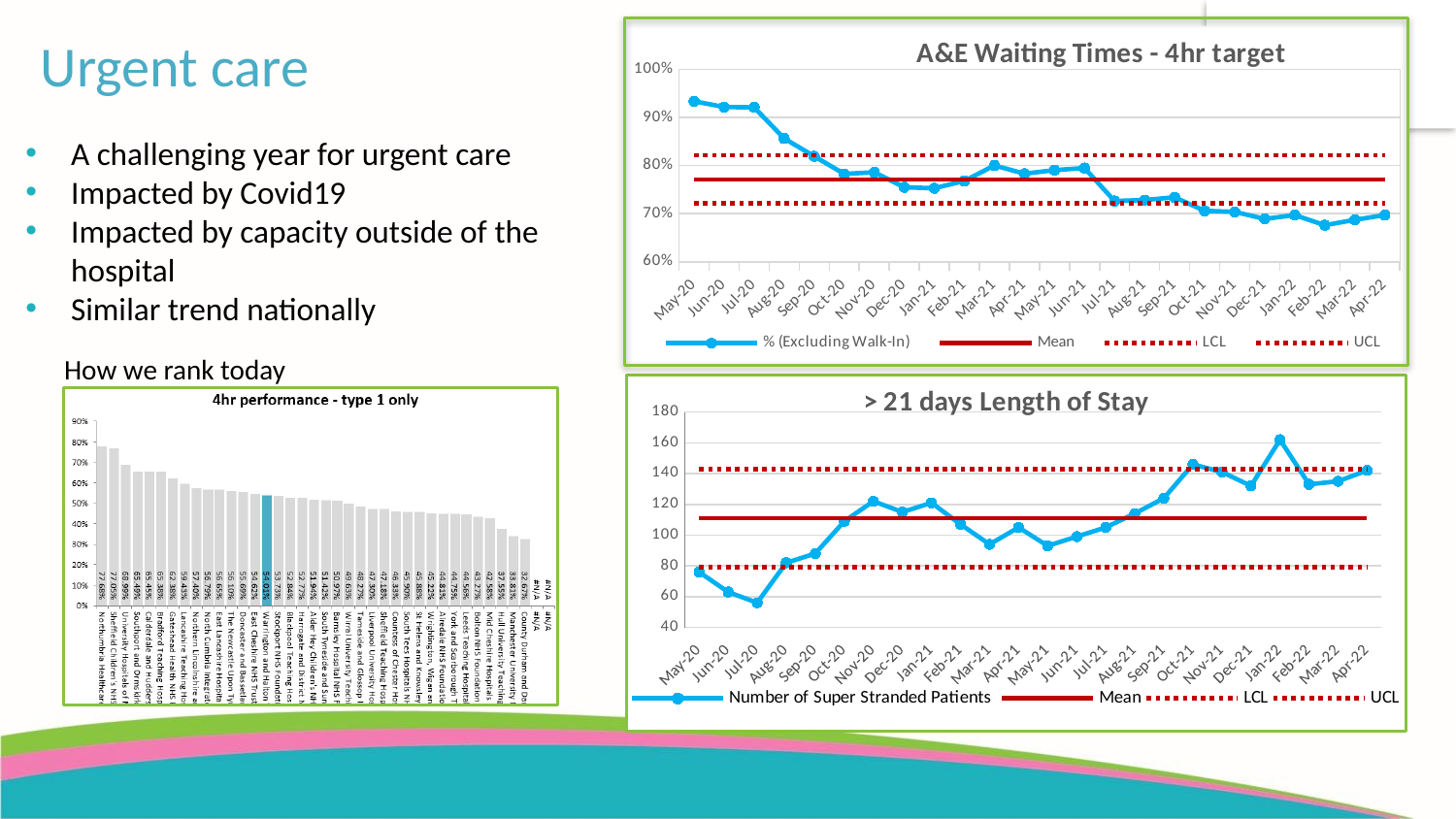
In the 'A&E Waiting Times - 4hr target' chart, which month has the highest value for % (Excluding Walk-In)? May-20 What kind of chart is the '4hr performance - type 1 only' chart? bar chart In the '> 21 days Length of Stay' chart, is the value for Jan-22 greater or less than 140? greater In the 'A&E Waiting Times - 4hr target' chart, is the value for Apr-22 greater or less than 80%? less In the 'A&E Waiting Times - 4hr target' chart, is the value for May-20 greater or less than 90%? greater In the 'A&E Waiting Times - 4hr target' chart, do the values generally rise or fall from May-20 to Apr-22? fall In the '> 21 days Length of Stay' chart, which month has the lowest number of super stranded patients? Jul-20 What kind of chart is the 'A&E Waiting Times - 4hr target' chart? line chart How many entries does the legend of the 'A&E Waiting Times - 4hr target' chart list? 4 In the '> 21 days Length of Stay' chart, which month has the highest number of super stranded patients? Jan-22 How many monthly data points are plotted in the '> 21 days Length of Stay' chart? 24